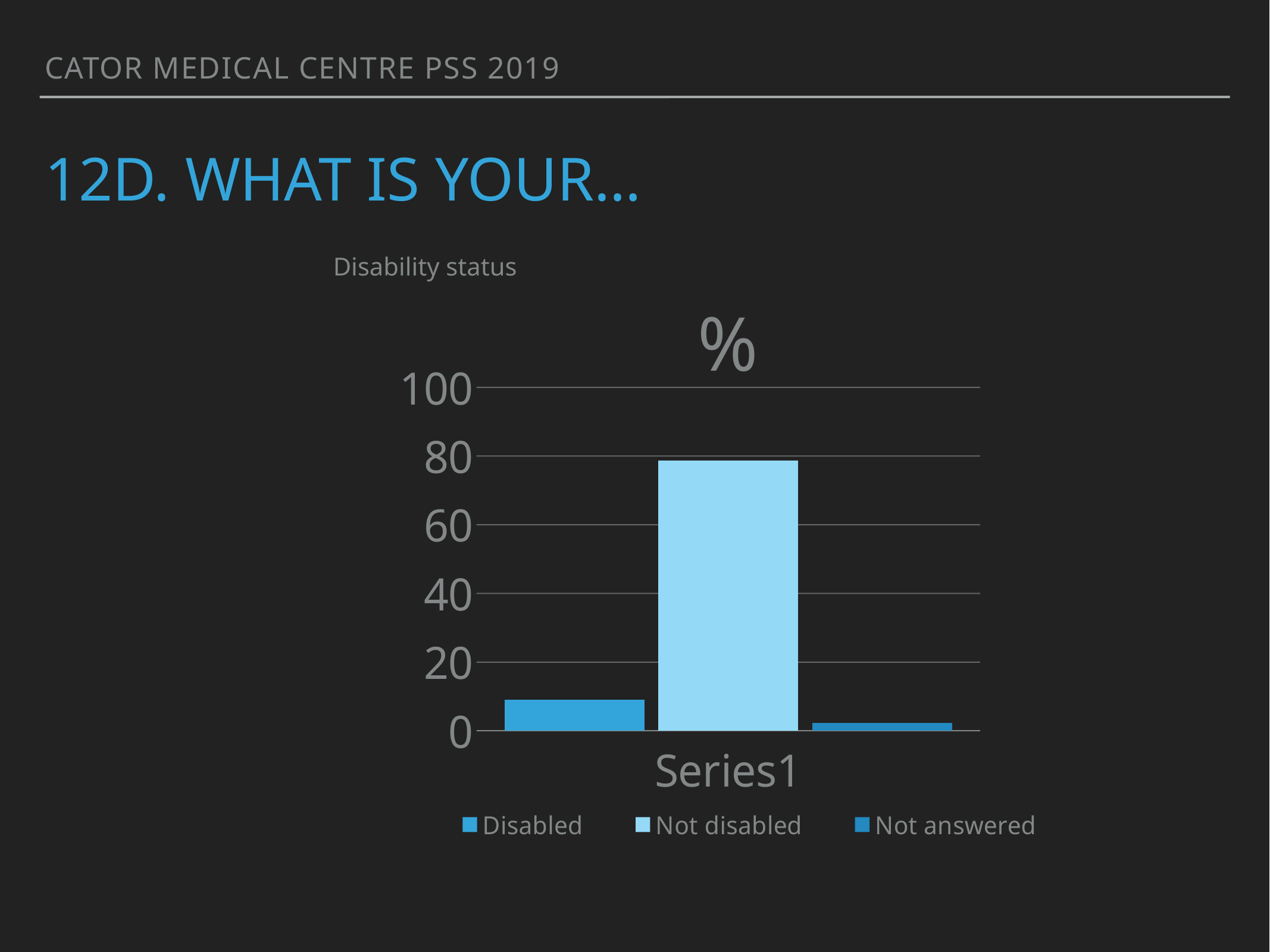
How many bars are plotted in the chart? 3 What label appears on the horizontal axis below the bars? Series1 Which legend entry has the lowest bar? Not answered Is the value for Not disabled greater or less than 100? less Which legend entry has the highest bar? Not disabled What kind of chart is shown on the slide? bar chart How many entries does the chart legend list? 3 Is the value for Not disabled greater or less than 60? greater What is the title of the chart? % Is the value for Disabled greater or less than 20? less Which is larger, the value for Disabled or the value for Not answered? Disabled